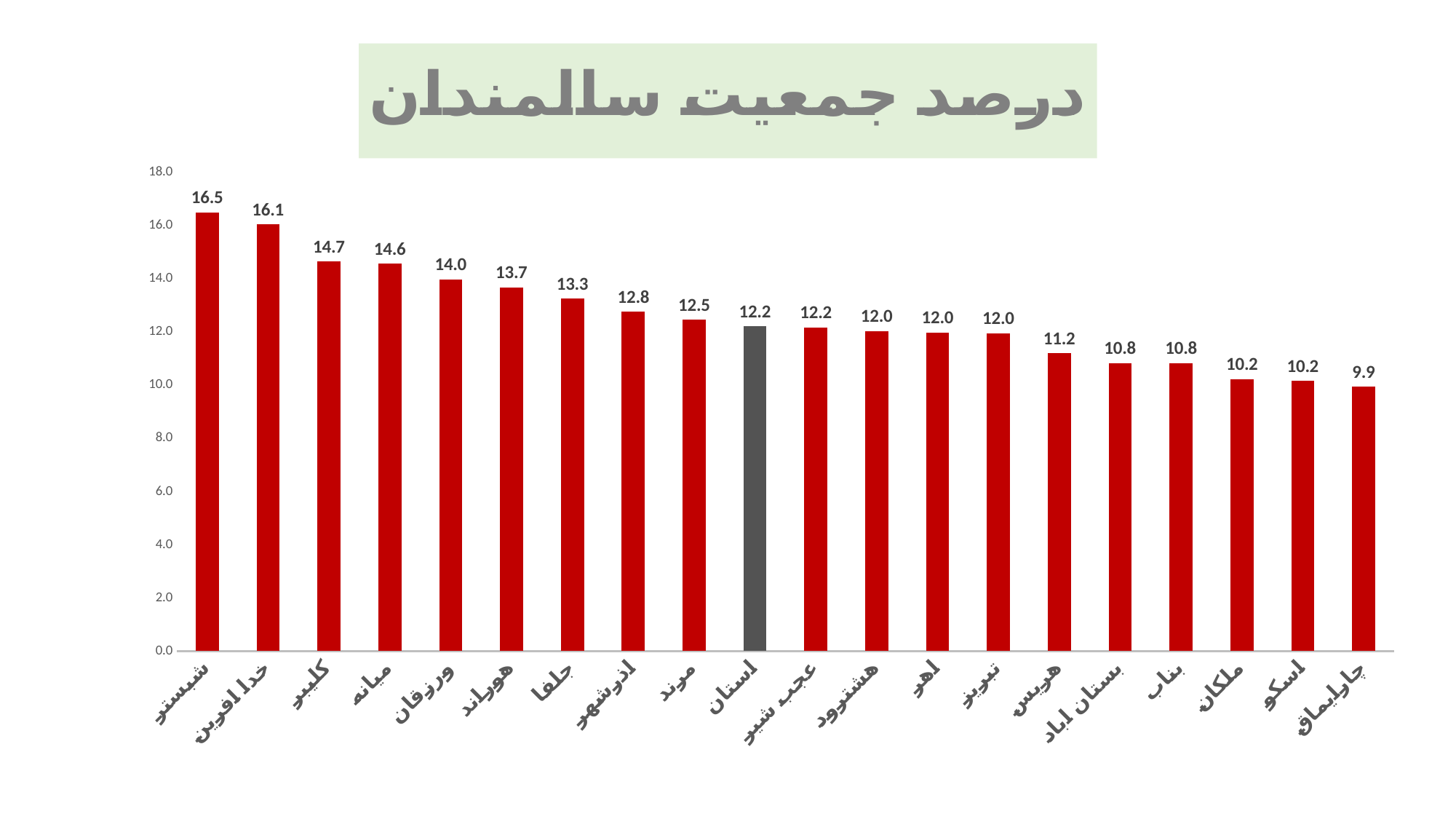
Which category has the lowest value? چارایماق What is the title of the chart? درصد جمعیت سالمندان What is the value for شبستر? 16.5 How many bars are shown in the chart? 20 Which category has the highest value? شبستر What is the difference between the values for کلیبر and هریس? 3.5 What is the value for تبریز? 12.0 Is the value for خدا آفرین greater or less than 14.0? greater What is the difference between the values for شبستر and چاراویماق? 6.6 What kind of chart is shown on the slide? Bar chart Which is larger, the value for جلفا or the value for مرند? جلفا What is the value for the gray bar labelled استان? 12.2